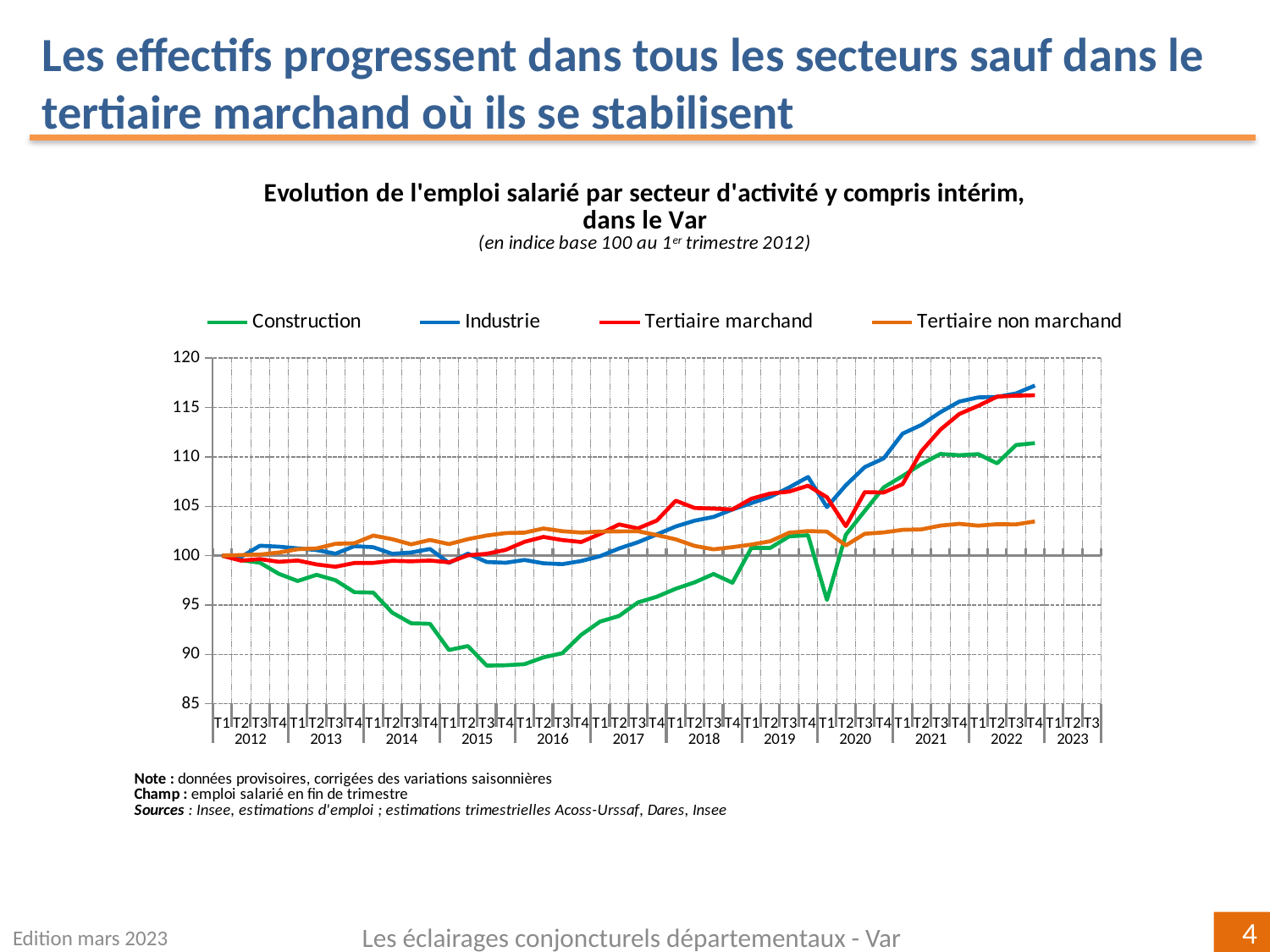
Is the value for Construction at T1 2020 greater or less than 100? less Which series has the lowest value in 2015? Construction Is the value for Industrie at T4 2022 greater or less than 115? greater Which series are listed in the legend? Construction, Industrie, Tertiaire marchand, Tertiaire non marchand How many series does the legend list? 4 Which series has the lowest value at T4 2022? Tertiaire non marchand What kind of chart is shown on the slide? line chart What colour is the Construction line? green Which is higher at T1 2016, Industrie or Construction? Industrie Is the value for Construction at T3 2015 greater or less than 90? less What is the index value of all four series at T1 2012? 100